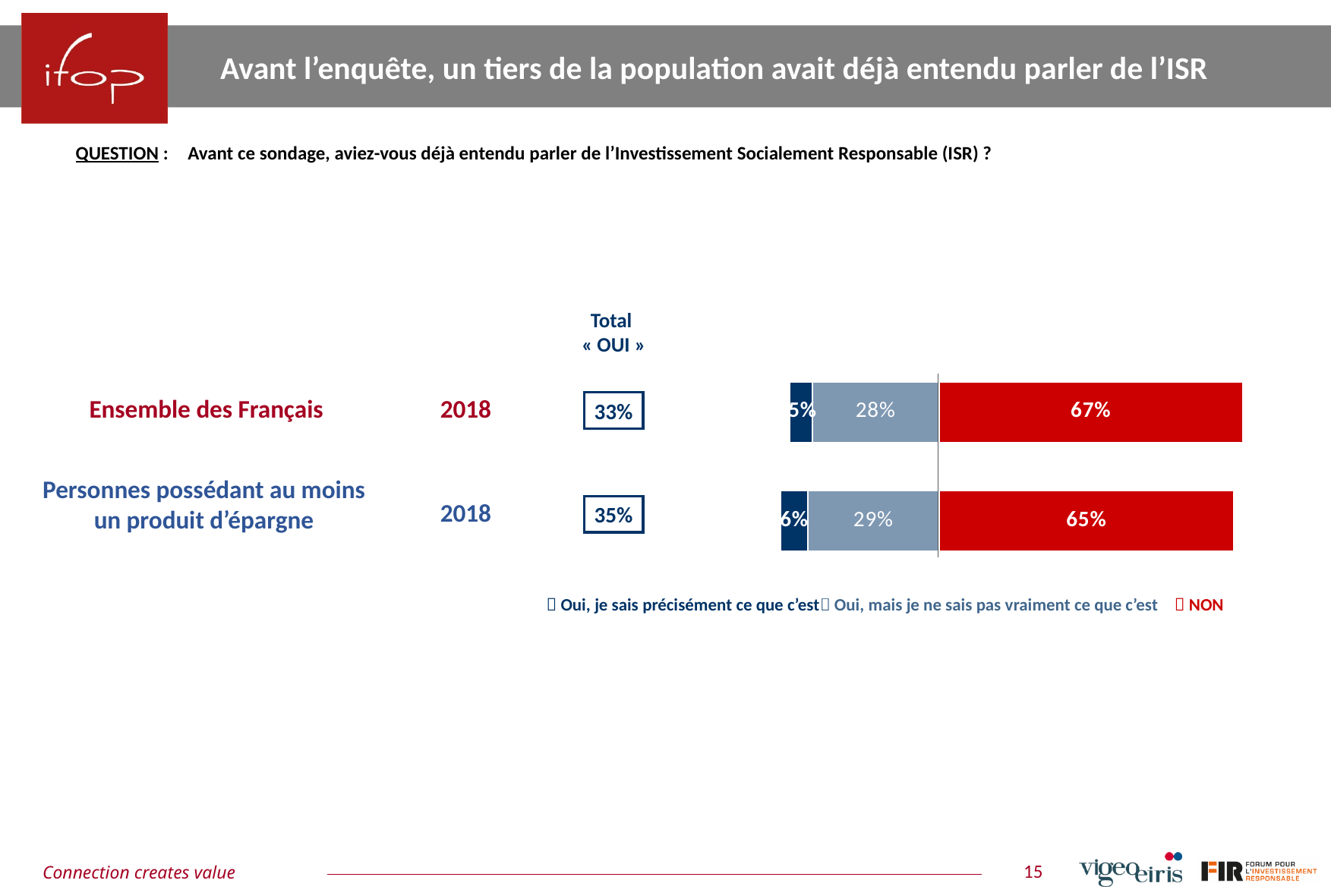
What is the difference between the 'NON' share for 'Ensemble des Français' and for 'Personnes possédant au moins un produit d'épargne'? 2 percentage points What is the 'Total « OUI »' for 'Personnes possédant au moins un produit d'épargne'? 35% What percentage of 'Ensemble des Français' answered 'NON'? 67% Which group has the higher 'NON' share: 'Ensemble des Français' or 'Personnes possédant au moins un produit d'épargne'? Ensemble des Français What percentage of 'Personnes possédant au moins un produit d'épargne' answered 'NON'? 65% What is the value of 'Oui, mais je ne sais pas vraiment ce que c'est' for 'Personnes possédant au moins un produit d'épargne'? 29% What kind of chart is shown on the slide? Stacked bar chart What colour represents the 'NON' answer in the chart? Red How many groups (bars) are shown in the chart? 2 How many response categories does the legend list? 3 What is the 'Total « OUI »' for 'Ensemble des Français'? 33% What is the value of 'Oui, mais je ne sais pas vraiment ce que c'est' for 'Ensemble des Français'? 28%